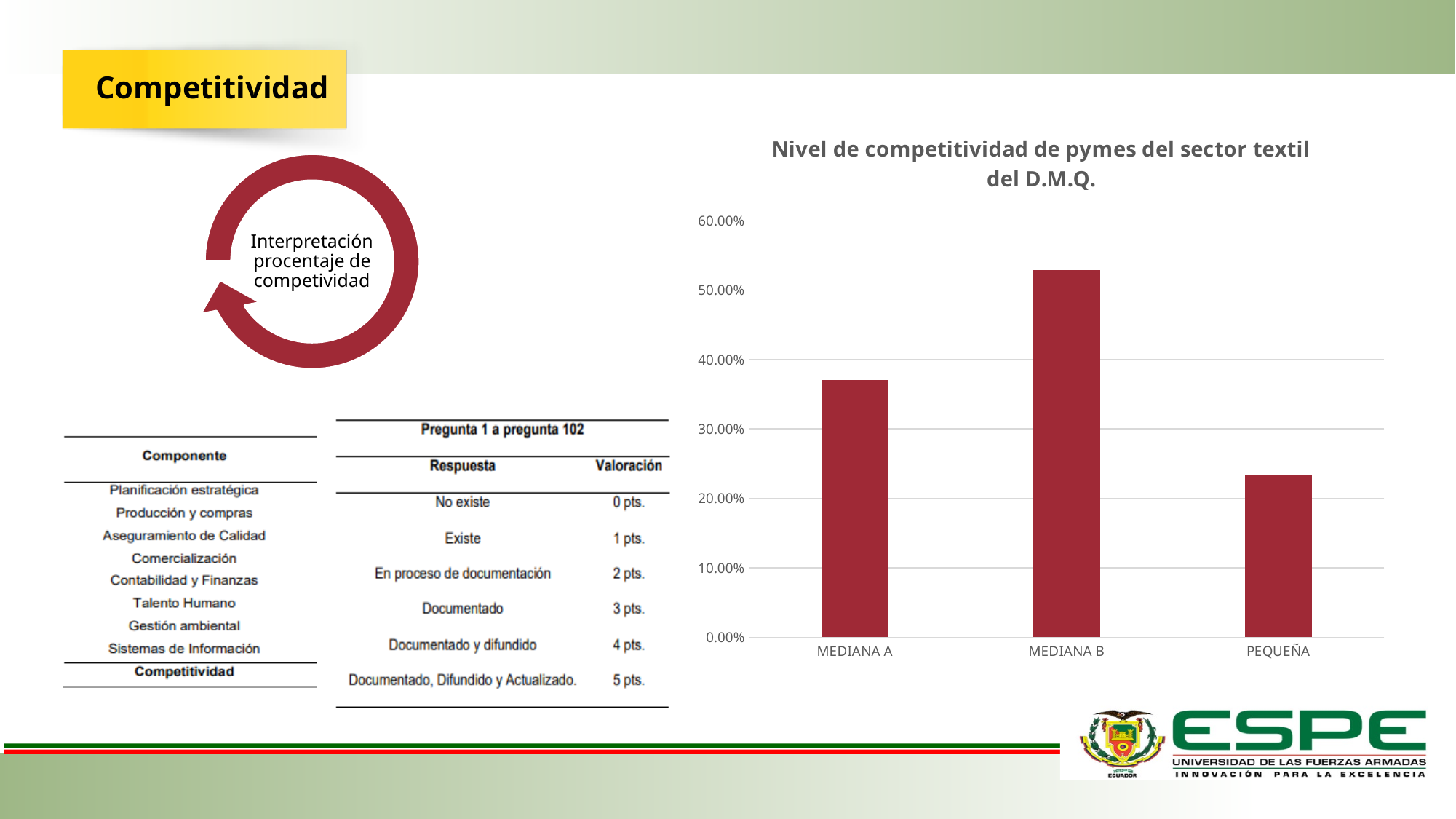
Is the value for MEDIANA B greater or less than 50.00%? greater What kind of chart is shown on the slide? bar chart Which is larger, the value for MEDIANA B or the value for MEDIANA A? MEDIANA B Which is larger, the value for MEDIANA A or the value for PEQUEÑA? MEDIANA A Is the value for MEDIANA A greater or less than 40.00%? less What is the title of the chart? Nivel de competitividad de pymes del sector textil del D.M.Q. What is the highest value shown on the y axis of the chart? 60.00% Is the value for MEDIANA A greater or less than 30.00%? greater Which category has the lowest value in the chart? PEQUEÑA Which category has the highest value in the chart? MEDIANA B How many categories are shown on the x axis of the chart? 3